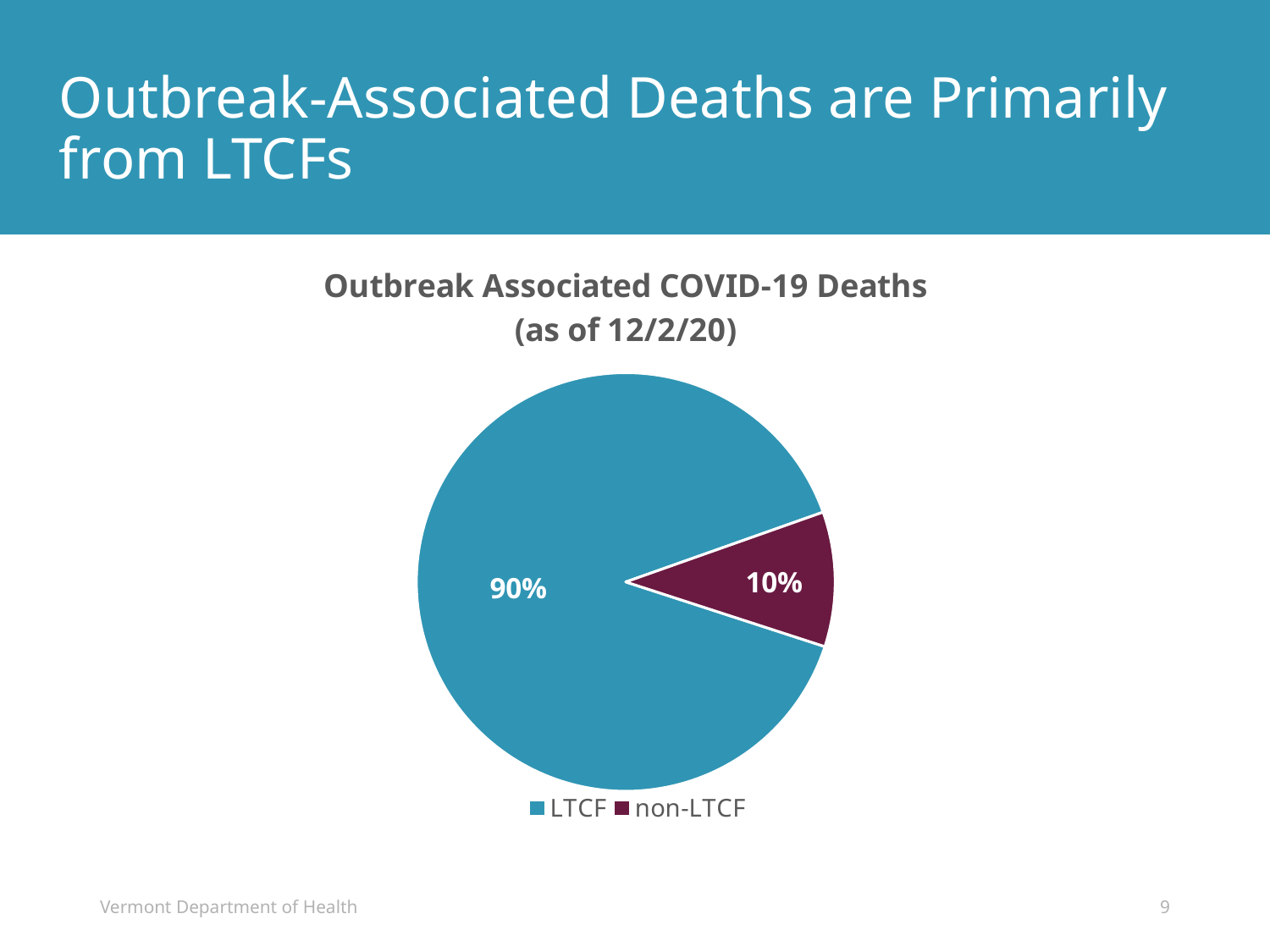
What is the difference in percentage points between the LTCF and non-LTCF slices? 80 Which is larger, the LTCF slice or the non-LTCF slice? LTCF Which category has the smallest slice of the pie? non-LTCF How many entries does the legend list? 2 What colour is the non-LTCF slice? dark red What kind of chart is shown on the slide? pie chart Which category has the largest slice of the pie? LTCF What share of outbreak-associated COVID-19 deaths is from non-LTCF? 10% How many categories does the pie chart show? 2 What share of outbreak-associated COVID-19 deaths is from LTCF? 90% What is the title of the chart? Outbreak Associated COVID-19 Deaths (as of 12/2/20)